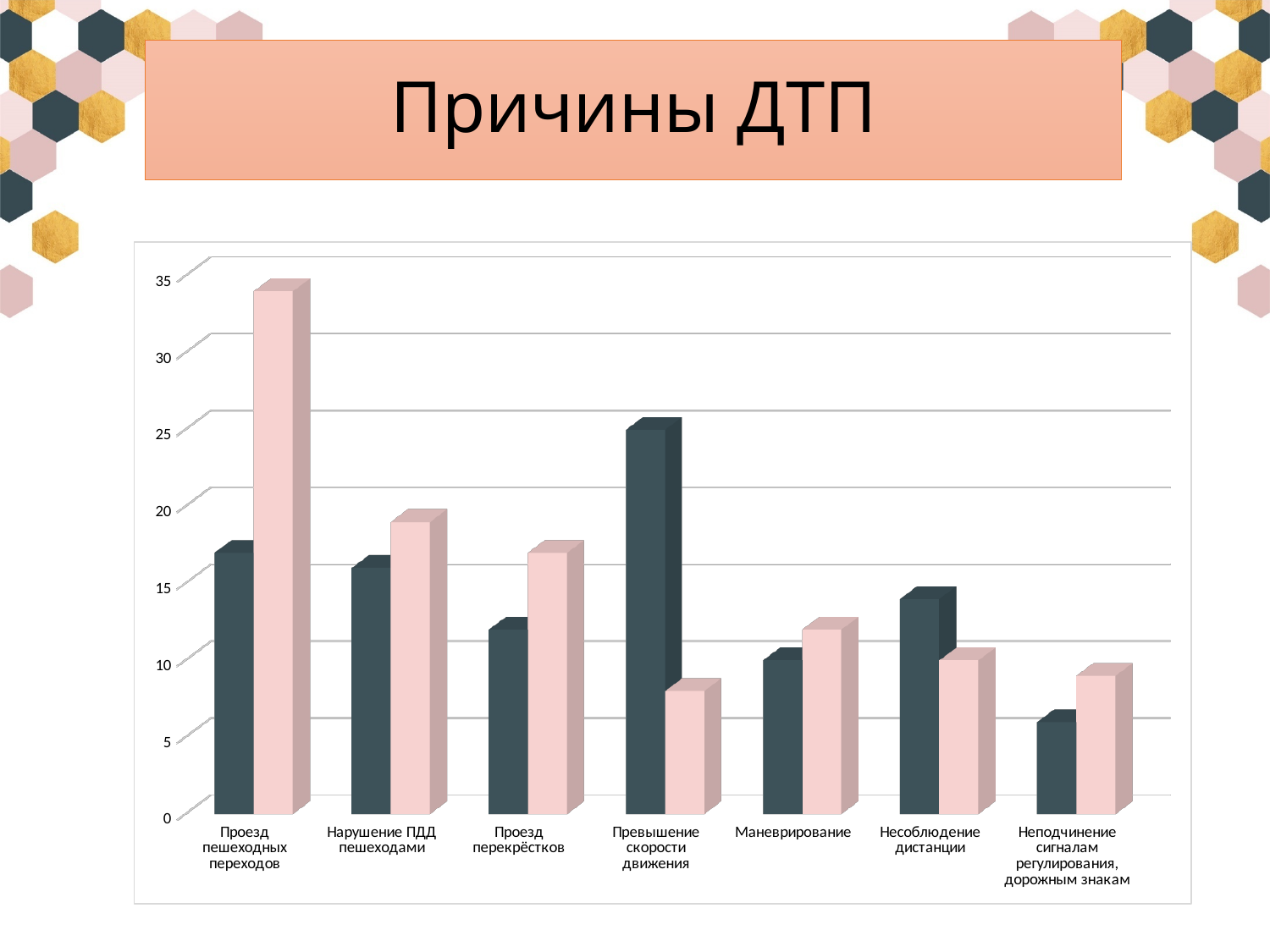
For Несоблюдение дистанции, which bar is taller, the dark one or the pink one? the dark one Which category has the tallest dark bar? Превышение скорости движения Which category has the shortest dark bar? Неподчинение сигналам регулирования, дорожным знакам Which category has the tallest pink bar? Проезд пешеходных переходов Is the pink bar for Проезд пешеходных переходов greater or less than 30? greater For Превышение скорости движения, which bar is taller, the dark one or the pink one? the dark one What kind of chart is shown on the slide? bar chart How many categories are shown on the x axis of the chart? 7 Is the pink bar for Превышение скорости движения greater or less than 10? less How many bars are plotted for each category in the chart? 2 What is the title of the slide containing the chart? Причины ДТП Is the dark bar for Превышение скорости движения greater or less than 20? greater